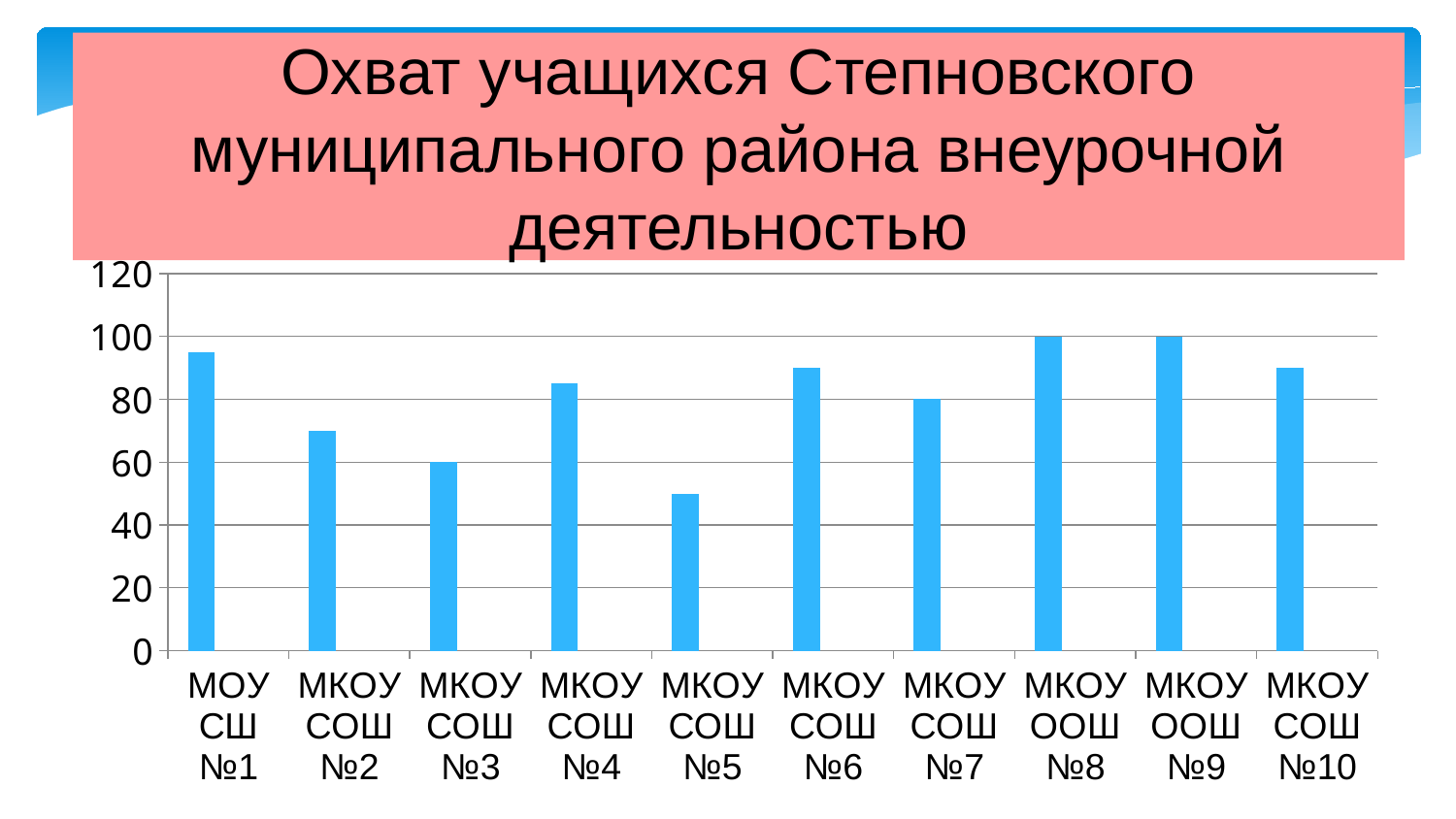
What is the difference between the values for МКОУ СОШ №7 and МКОУ СОШ №3? 20 What is the title of the chart? Охват учащихся Степновского муниципального района внеурочной деятельностью How many schools (categories) are shown on the x axis? 10 What is the value for МКОУ СОШ №7? 80 Is the value for МКОУ СОШ №5 greater or less than 60? less Is the value for МОУ СШ №1 greater or less than 80? greater What kind of chart is shown on the slide? bar chart Which is larger, the value for МКОУ СОШ №4 or МКОУ СОШ №5? МКОУ СОШ №4 Which school has the lowest value? МКОУ СОШ №5 What is the value for МКОУ СОШ №3? 60 Is the value for МКОУ СОШ №2 greater or less than 80? less What is the value for МКОУ ООШ №8? 100